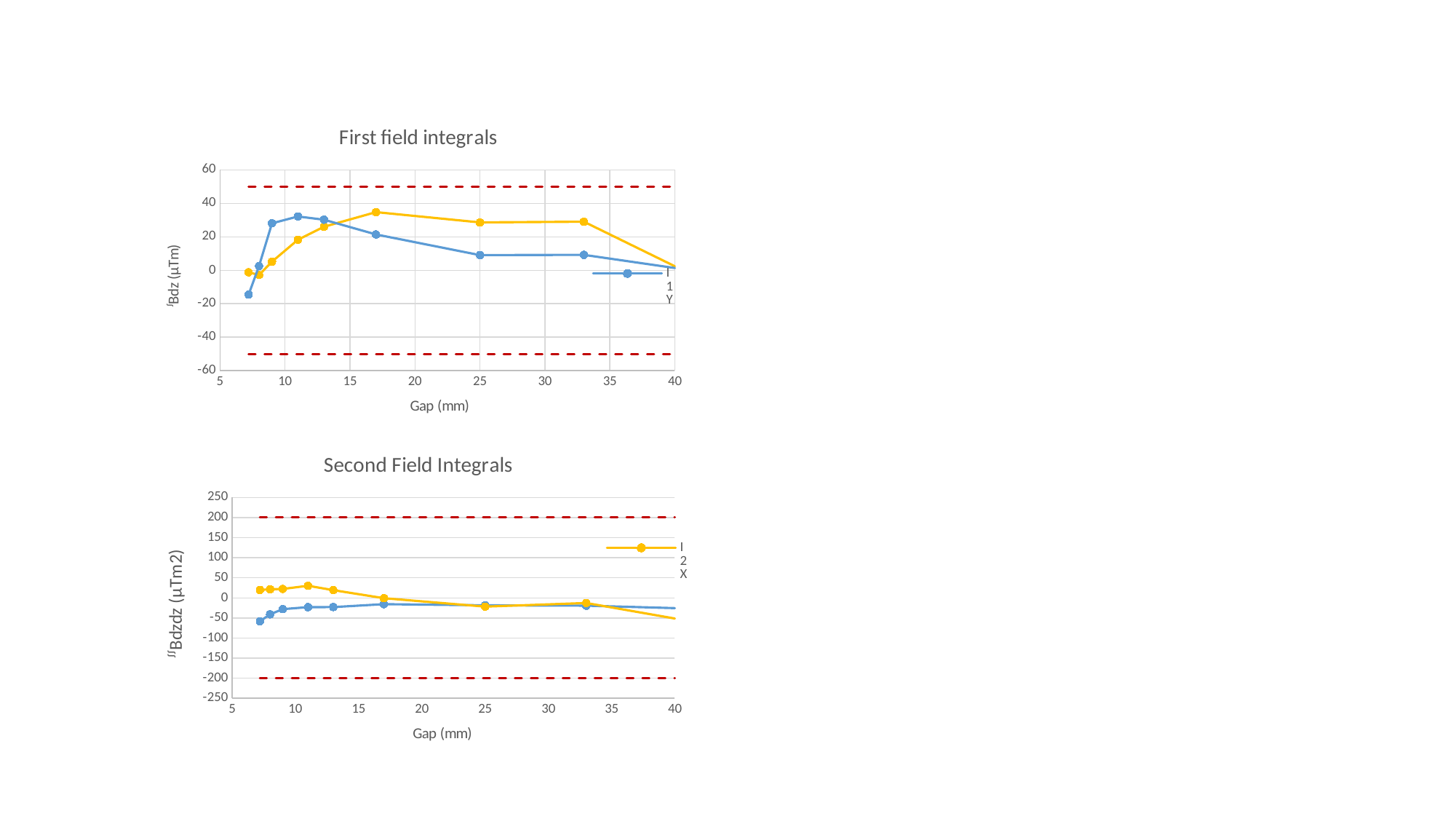
In the "First field integrals" chart, is the value of the yellow series at a gap of 17 mm greater or less than 20? greater In the "First field integrals" chart, is the value of the blue series at a gap of 7 mm greater or less than 0? less In the "First field integrals" chart, at a gap of 25 mm, which series has the larger value, the blue or the yellow? yellow What is the x-axis label of the "Second Field Integrals" chart? Gap (mm) In the "Second Field Integrals" chart, at a gap of 7 mm, which series has the larger value, the blue or the yellow? yellow In the "First field integrals" chart, does the blue series rise or fall as the gap increases from 11 mm to 40 mm? fall What is the title of the top chart on the slide? First field integrals What kind of chart is the "First field integrals" chart? line chart In the "Second Field Integrals" chart, does the yellow series rise or fall as the gap increases from 11 mm to 40 mm? fall In the "Second Field Integrals" chart, is the value of the yellow series at a gap of 11 mm greater or less than 0? greater